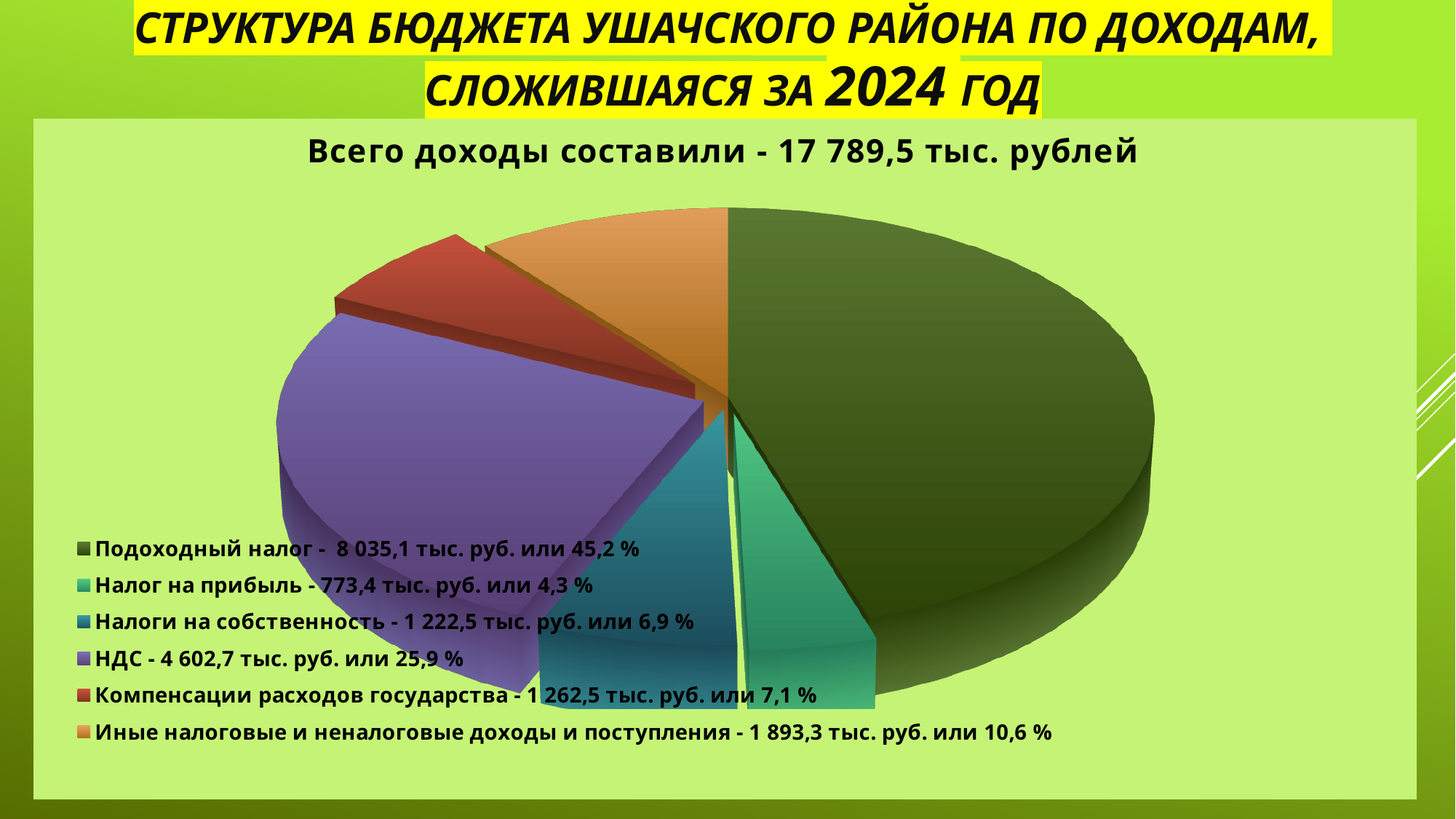
What is the value for Налоги на собственность? 1 222,5 тыс. руб. What is the total income stated in the chart title? 17 789,5 тыс. рублей Which category has the largest share of the pie? Подоходный налог How many categories does the pie chart have? 6 Which category has the smallest share of the pie? Налог на прибыль What kind of chart is shown on the slide? Pie chart What share of the pie does НДС represent? 25,9 % What share of the pie do Иные налоговые и неналоговые доходы и поступления represent? 10,6 % What is the difference in percentage share between Подоходный налог and НДС? 19,3 % What colour is the slice for НДС? Purple What is the value for Подоходный налог? 8 035,1 тыс. руб. Which is larger: Компенсации расходов государства or Налоги на собственность? Компенсации расходов государства